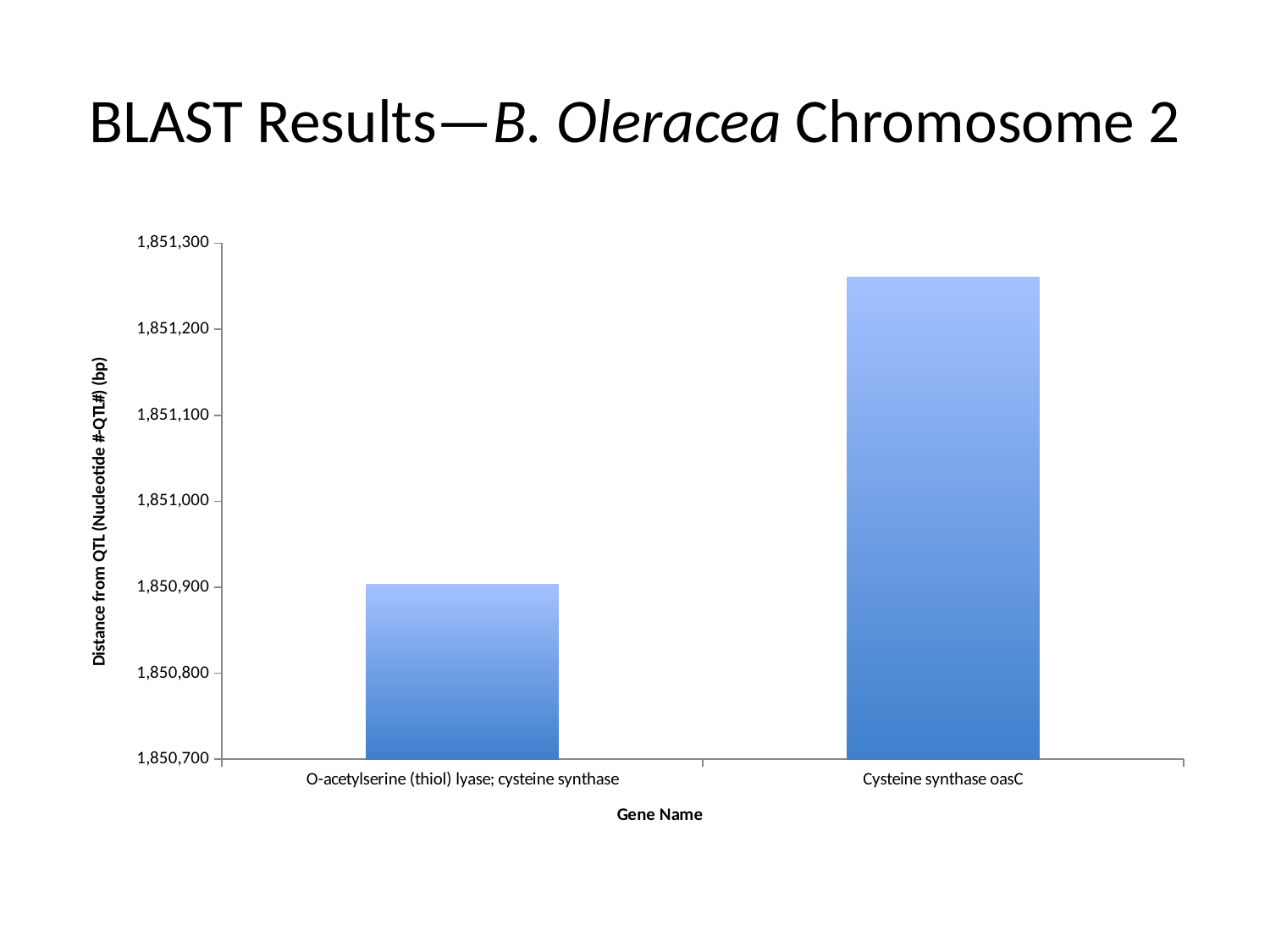
What is the label of the x axis? Gene Name Which gene has the highest distance from QTL? Cysteine synthase oasC Which has the larger distance from QTL: O-acetylserine (thiol) lyase; cysteine synthase or Cysteine synthase oasC? Cysteine synthase oasC Do the bar values rise or fall from left to right along the x axis? rise Which gene has the lowest distance from QTL? O-acetylserine (thiol) lyase; cysteine synthase Is the value for Cysteine synthase oasC greater or less than 1,851,300? less How many genes (categories) are plotted on the chart? 2 Is the value for O-acetylserine (thiol) lyase; cysteine synthase greater or less than 1,851,000? less What kind of chart is shown on the slide? bar chart Is the value for O-acetylserine (thiol) lyase; cysteine synthase greater or less than 1,850,800? greater What is the title of the slide? BLAST Results—B. Oleracea Chromosome 2